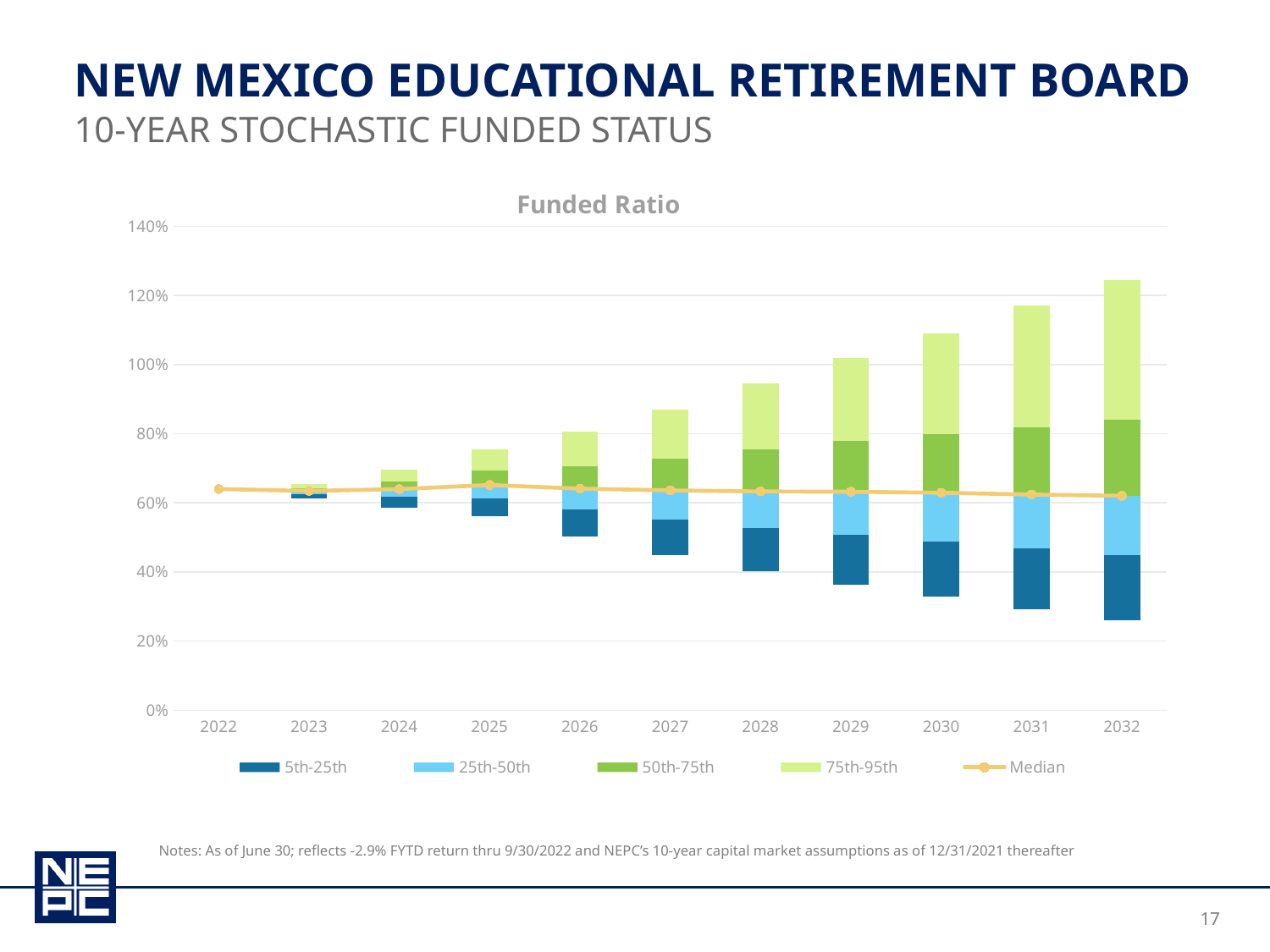
How many series does the legend list? 5 Does the top of the 75th-95th range rise or fall from 2022 to 2032? rise Which year has the highest top of the 75th-95th percentile range? 2032 Is the top of the 75th-95th range for 2029 greater or less than 100%? greater How many years are shown on the x axis? 11 Is the top of the 75th-95th range for 2032 greater or less than 120%? greater What kind of chart is shown on the slide? Stacked bar chart with a line Which legend entry is drawn as a line with markers rather than a bar? Median What is the title of the chart? Funded Ratio Is the top of the 75th-95th range larger in 2031 or in 2028? 2031 Which year has the lowest bottom of the 5th-25th percentile range? 2032 Is the bottom of the 5th-25th range for 2032 greater or less than 40%? less